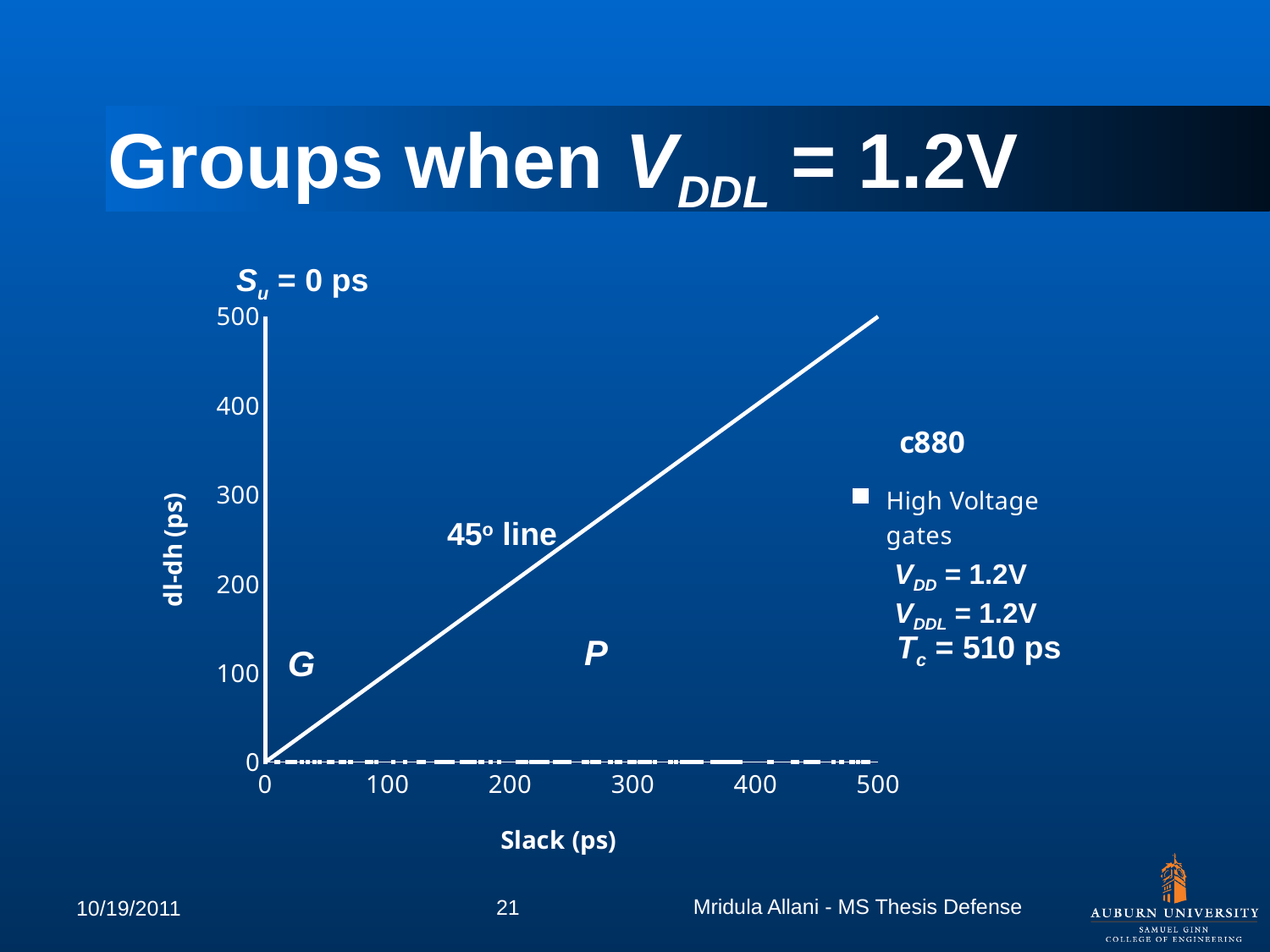
What is the label of the y axis? dl-dh (ps) What is the highest value shown on the y axis? 500 Does the 45° line rise or fall as Slack increases? rises Which region label is placed above the 45° line near the y axis, G or P? G What is the label of the x axis? Slack (ps) Are the dl-dh values of the plotted points greater or less than 100? less What is the highest value shown on the x axis? 500 What is the legend entry for the plotted series? High Voltage gates What kind of chart is shown on the slide? scatter chart What is the title printed above the legend of the chart? c880 What dl-dh (ps) value do the plotted High Voltage gates points lie on? 0 How many series does the chart legend list? 1